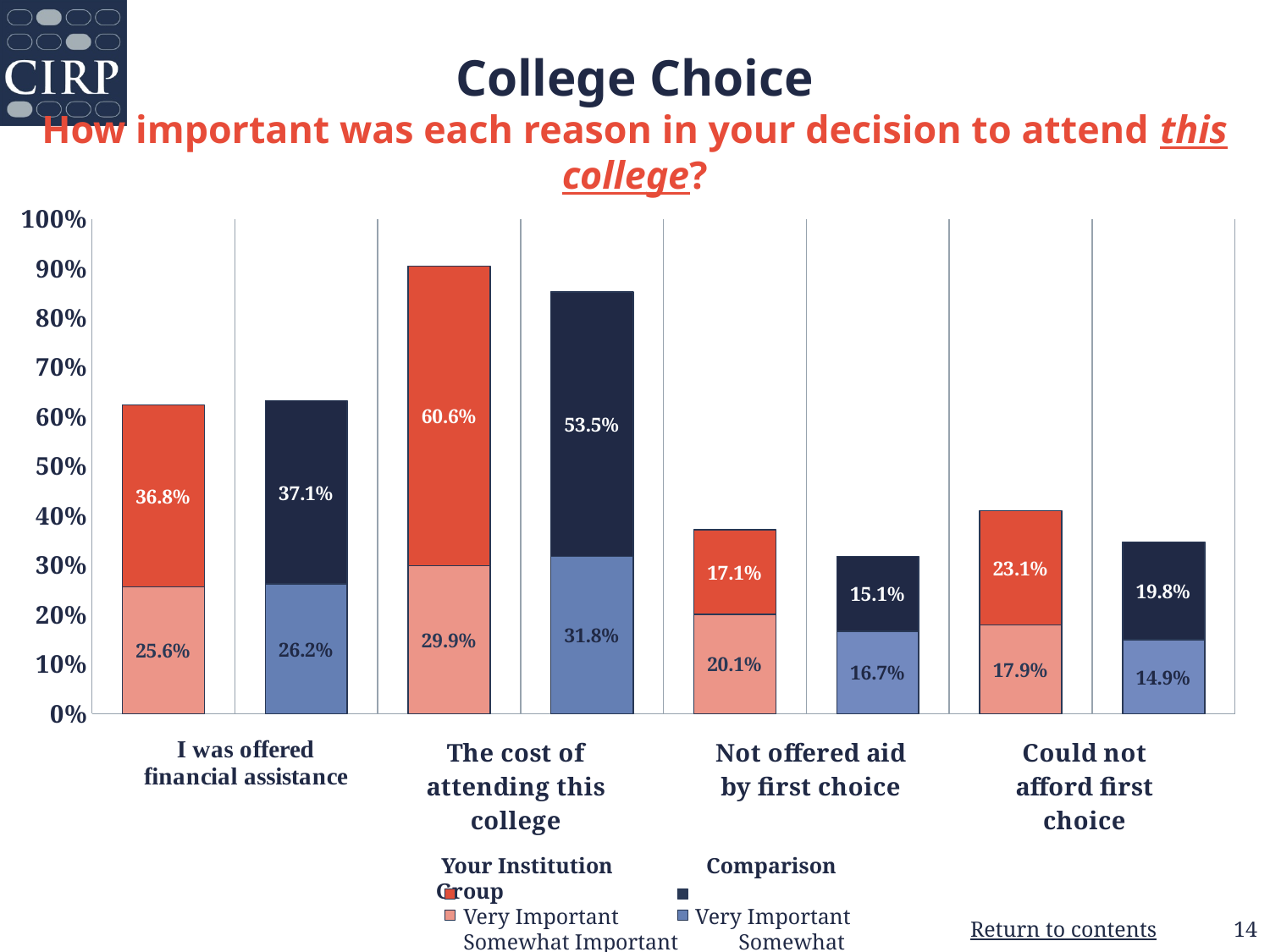
Which reason has the highest Very Important percentage for the Comparison Group? The cost of attending this college For 'Could not afford first choice', which group has the larger Very Important percentage, Your Institution or the Comparison Group? Your Institution What percentage of students at Your Institution rated 'The cost of attending this college' as Very Important? 60.6% What is the combined Very Important and Somewhat Important percentage for the Comparison Group for 'I was offered financial assistance'? 63.3% Is the total stacked value for the Comparison Group for 'Not offered aid by first choice' greater or less than 40%? less What is the combined Very Important and Somewhat Important percentage for Your Institution for 'The cost of attending this college'? 90.5% What percentage of the Comparison Group rated 'Could not afford first choice' as Somewhat Important? 14.9% What percentage of students at Your Institution rated 'Not offered aid by first choice' as Somewhat Important? 20.1% What is the difference between Your Institution's and the Comparison Group's Very Important percentages for 'The cost of attending this college'? 7.1% Which reason has the lowest Very Important percentage for Your Institution? Not offered aid by first choice What type of chart is shown on the slide? Stacked bar chart How many reasons (categories) are shown on the x axis of the chart? 4